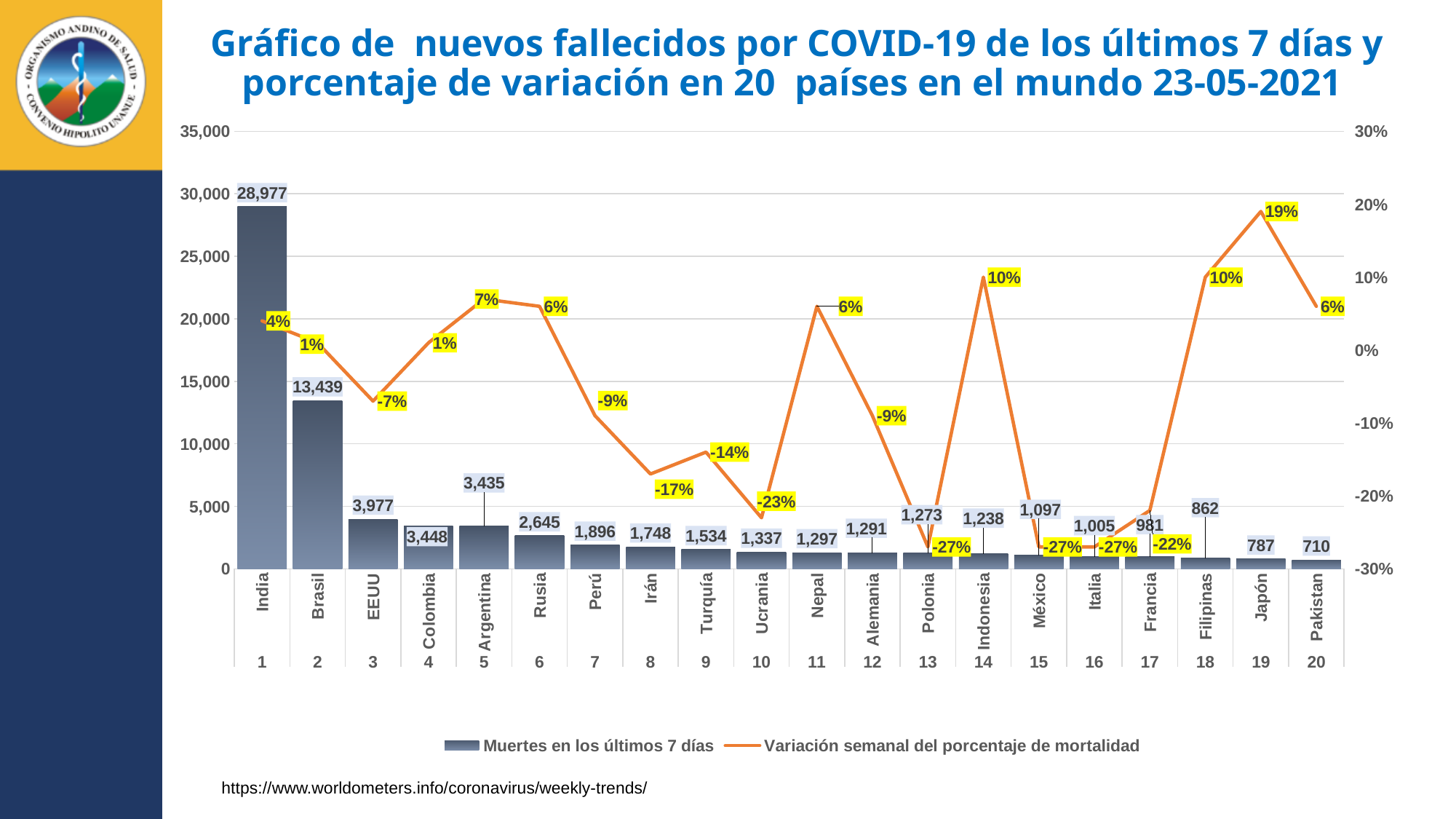
What is the weekly variation percentage shown for Ucrania? -23% Which country has the lowest number of deaths in the last 7 days? Pakistan How many series does the legend list? 2 How many countries are shown on the chart? 20 Which country has the highest number of deaths in the last 7 days? India Which has more deaths in the last 7 days, EEUU or Colombia? EEUU How many deaths in the last 7 days are shown for Francia? 981 How many deaths in the last 7 days are shown for Brasil? 13,439 What is the weekly variation percentage shown for Japón? 19% What colour is the line for 'Variación semanal del porcentaje de mortalidad'? Orange What kind of chart is used to show the deaths in the last 7 days? Bar chart What is the difference in deaths in the last 7 days between India and Brasil? 15,538